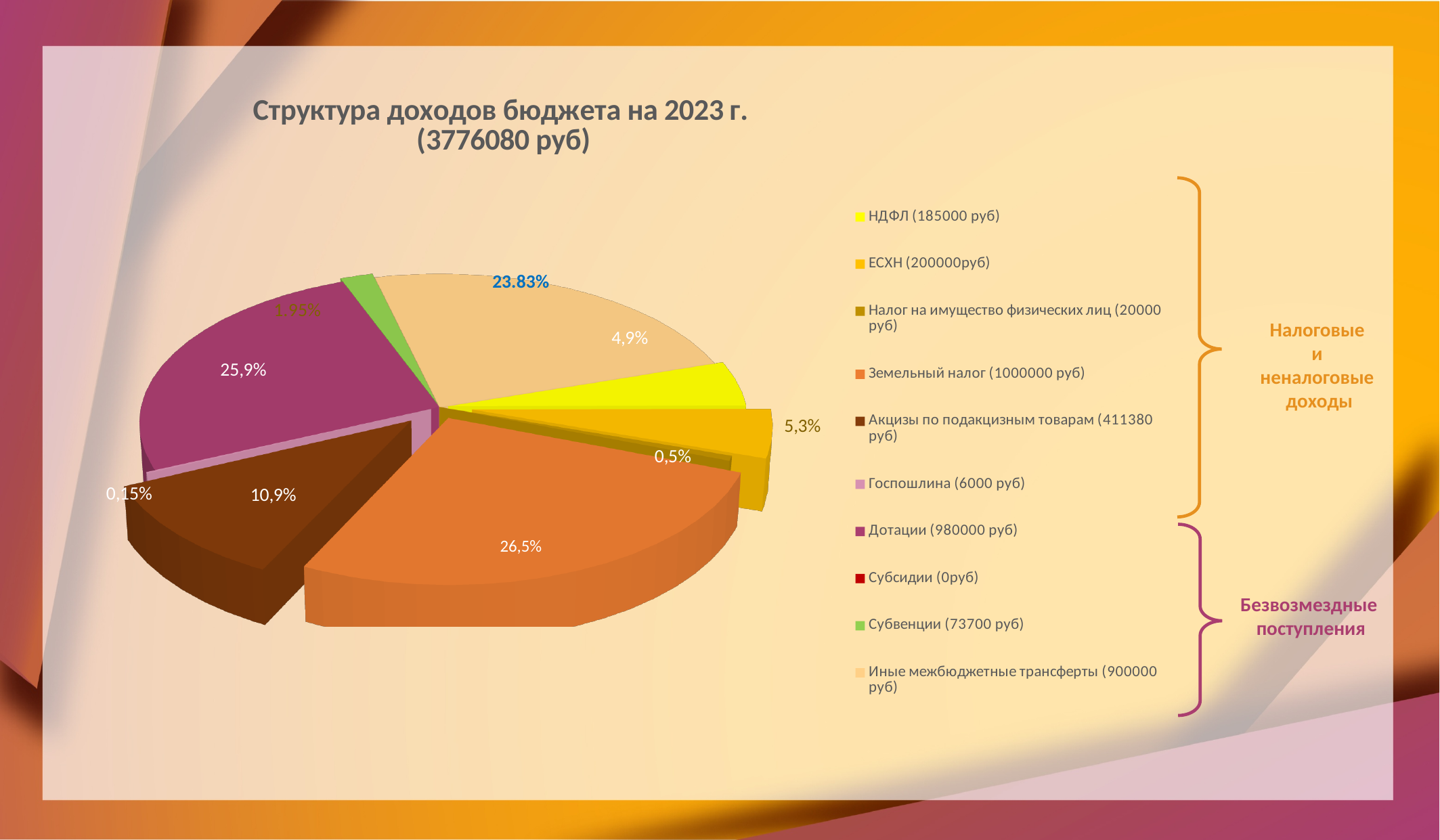
What kind of chart is shown on the slide? Pie chart What is the title of the chart? Структура доходов бюджета на 2023 г. (3776080 руб) What percentage share does the Земельный налог slice have? 26,5% What percentage share does the Дотации slice have? 25,9% Which category has the smallest share among the slices with a printed percentage? Госпошлина How many categories does the legend list? 10 Which is larger, the Дотации slice or the Иные межбюджетные трансферты slice? Дотации What percentage share does the Иные межбюджетные трансферты slice have? 23.83% Which category has the largest share of the pie? Земельный налог What is the difference in percentage points between the Земельный налог and Дотации slices? 0,6% According to the legend, what is the amount in rubles for Субвенции? 73700 руб